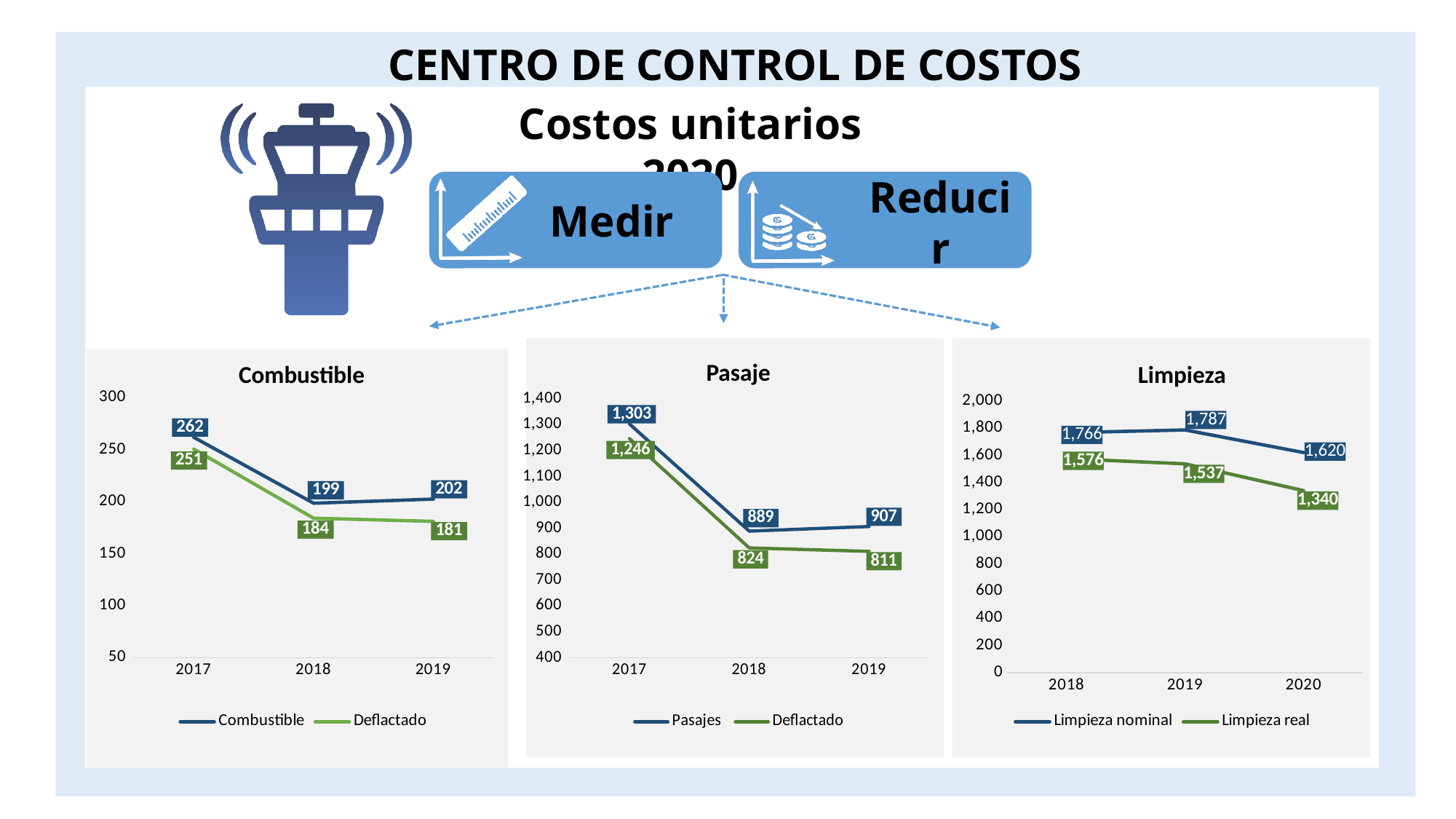
How many series does the legend of the Pasaje chart list? 2 In the Limpieza chart, what is the value of Limpieza real in 2020? 1,340 In the Limpieza chart, which year has the highest Limpieza nominal value? 2019 In the Limpieza chart, is the Limpieza nominal value in 2018 or the Limpieza real value in 2018 larger? Limpieza nominal In the Pasaje chart, which year has the lowest Deflactado value? 2019 What kind of chart is the Combustible chart? line chart In the Combustible chart, what is the difference between the Combustible and Deflactado values in 2018? 15 In the Pasaje chart, what is the value of the Pasajes series in 2017? 1,303 In the Combustible chart, what is the value of the Combustible series in 2017? 262 In the Combustible chart, what is the value of the Deflactado series in 2019? 181 In the Limpieza chart, does the Limpieza real series rise or fall from 2018 to 2020? fall In the Pasaje chart, what is the difference between the Pasajes values in 2017 and 2018? 414